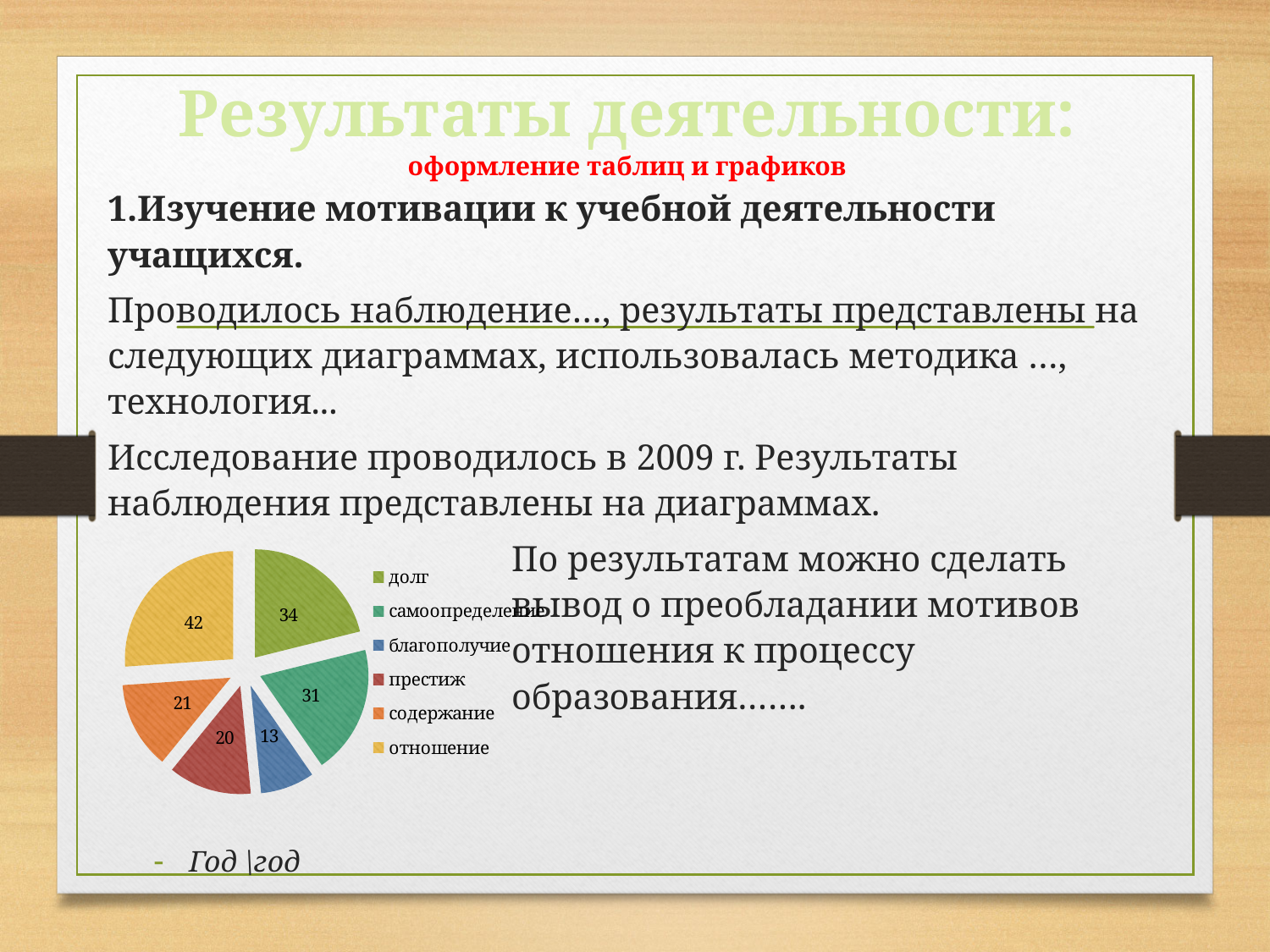
What kind of chart is shown on the slide? pie chart What is the value for the slice labelled благополучие? 13 What is the value for the slice labelled самоопределение? 31 What is the value for the slice labelled долг? 34 Which category has the largest slice in the pie chart? отношение What colour is the slice for отношение? yellow What is the value for the slice labelled отношение? 42 Which category has the smallest slice in the pie chart? благополучие Which is larger, the value for долг or the value for самоопределение? долг How many slices does the pie chart have? 6 What is the difference between the values for отношение and долг? 8 What is the sum of all the values shown in the pie chart? 161